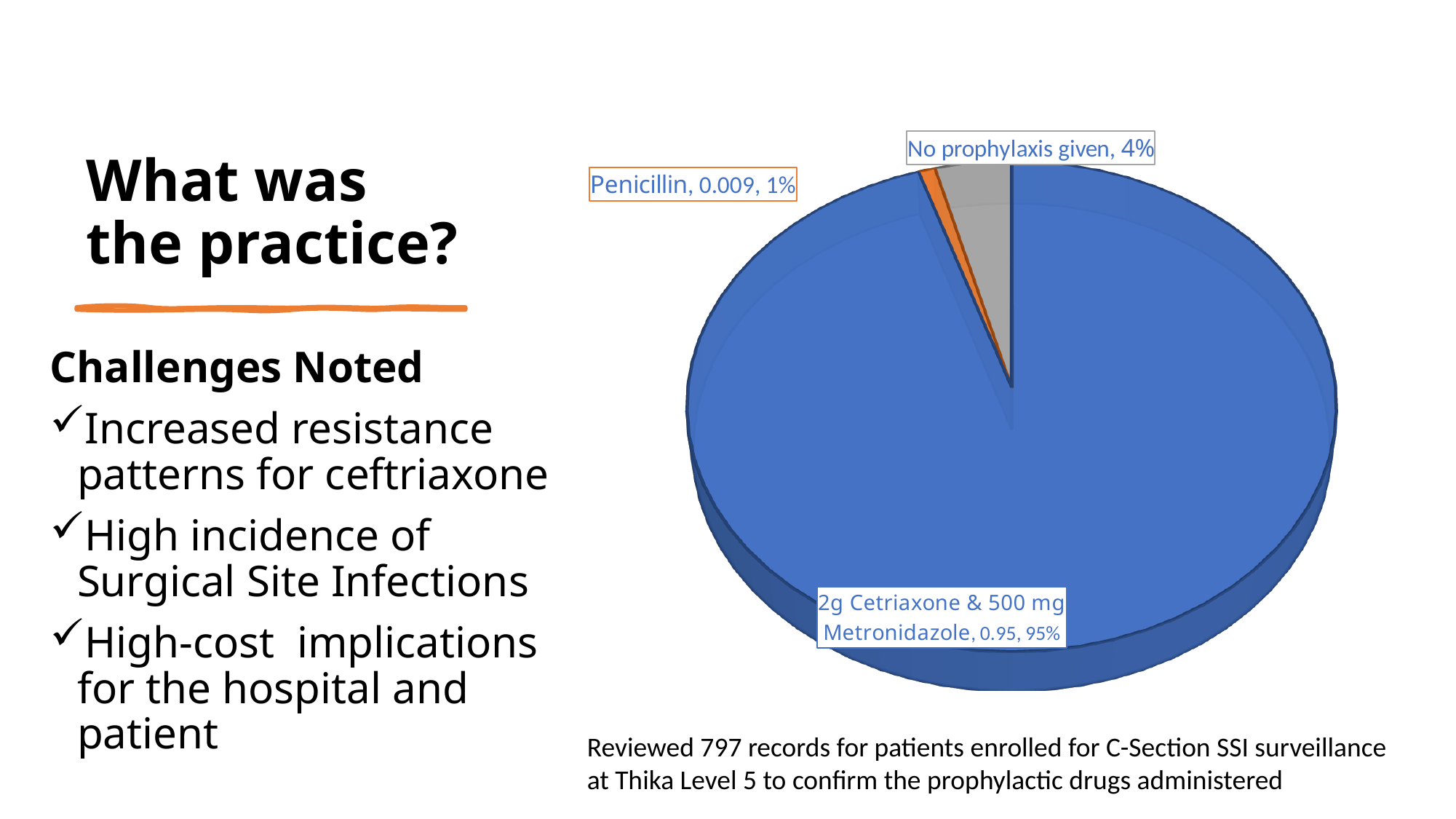
What percentage of the pie is labelled "2g Cetriaxone & 500 mg Metronidazole"? 95% Which is larger: the No prophylaxis given slice or the Penicillin slice? No prophylaxis given What colour is the Penicillin slice in the pie chart? orange How many slices does the pie chart have? 3 What percentage of the pie is labelled "Penicillin"? 1% What percentage of the pie is labelled "No prophylaxis given"? 4% What value is printed for the 2g Cetriaxone & 500 mg Metronidazole slice before its percentage? 0.95 What value is printed for the Penicillin slice before its percentage? 0.009 Which slice of the pie chart is the largest? 2g Cetriaxone & 500 mg Metronidazole What kind of chart is shown on the slide? pie chart Which slice of the pie chart is the smallest? Penicillin What is the difference in percentage points between the No prophylaxis given slice and the Penicillin slice? 3